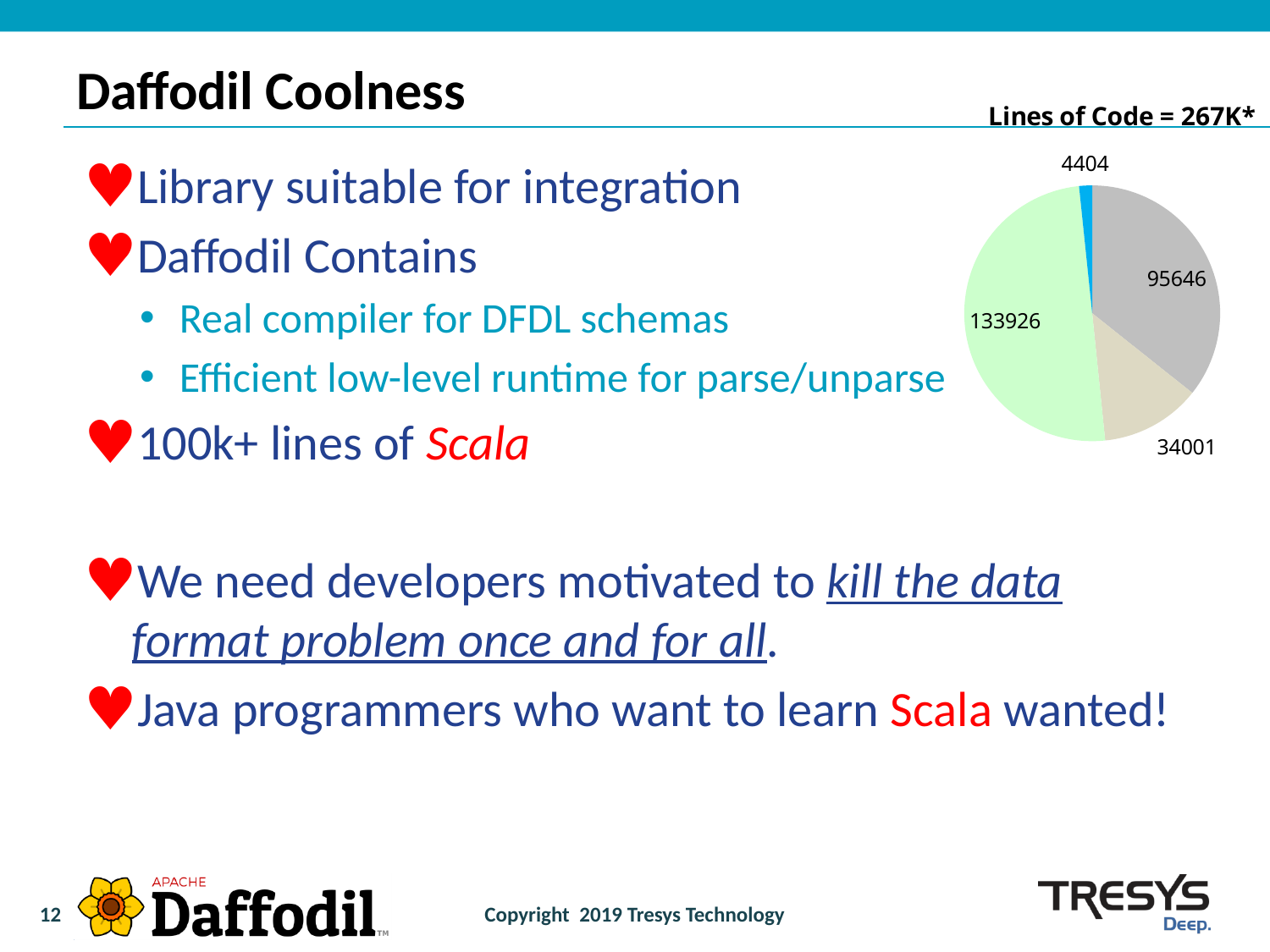
What value is labelled on the gray slice of the pie chart? 95646 What kind of chart is shown on the slide? pie chart What value is labelled on the light green slice of the pie chart? 133926 What value is labelled on the smallest slice of the pie chart? 4404 What is the difference between the slice labelled 95646 and the slice labelled 34001? 61645 What is the difference between the slice labelled 133926 and the slice labelled 95646? 38280 Which slice is larger, the one labelled 95646 or the one labelled 34001? 95646 What value is labelled on the blue slice of the pie chart? 4404 How many slices does the pie chart have? 4 What is the title of the chart? Lines of Code = 267K* What value is labelled on the beige slice of the pie chart? 34001 What value is labelled on the largest slice of the pie chart? 133926